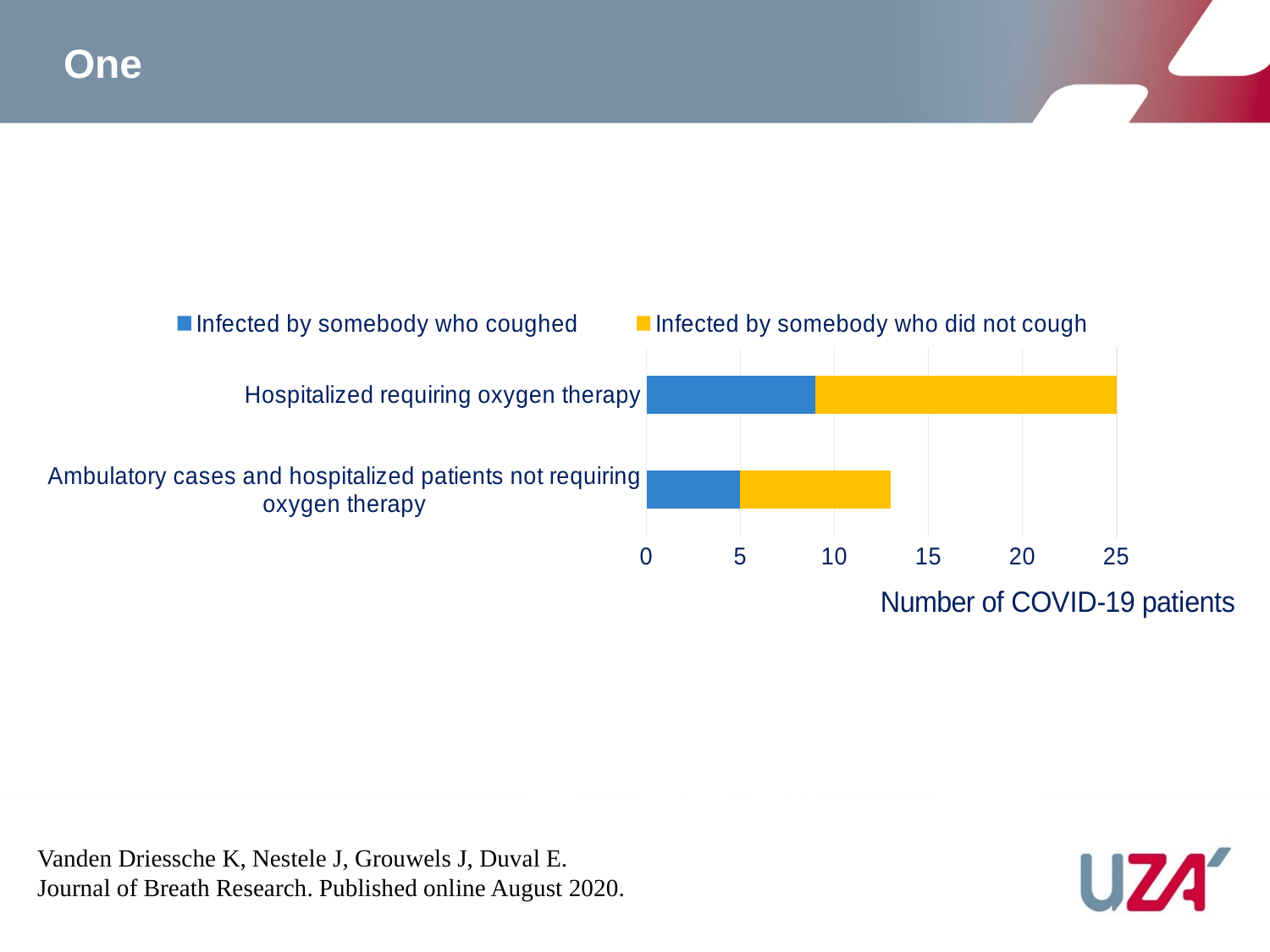
What kind of chart is shown on the slide? Stacked bar chart Which category has the smaller total number of COVID-19 patients? Ambulatory cases and hospitalized patients not requiring oxygen therapy Is the 'Infected by somebody who coughed' value for 'Hospitalized requiring oxygen therapy' greater or less than 5? greater Which category has the larger total number of COVID-19 patients? Hospitalized requiring oxygen therapy Is the total for 'Ambulatory cases and hospitalized patients not requiring oxygen therapy' greater or less than 15? less What colour represents 'Infected by somebody who did not cough' in the legend? Yellow What is the title of the horizontal axis? Number of COVID-19 patients How many series does the legend list? 2 How many categories are plotted on the chart? 2 Is the total for 'Ambulatory cases and hospitalized patients not requiring oxygen therapy' greater or less than 10? greater What is the total number of COVID-19 patients for 'Hospitalized requiring oxygen therapy'? 25 For 'Hospitalized requiring oxygen therapy', which is larger: 'Infected by somebody who coughed' or 'Infected by somebody who did not cough'? Infected by somebody who did not cough